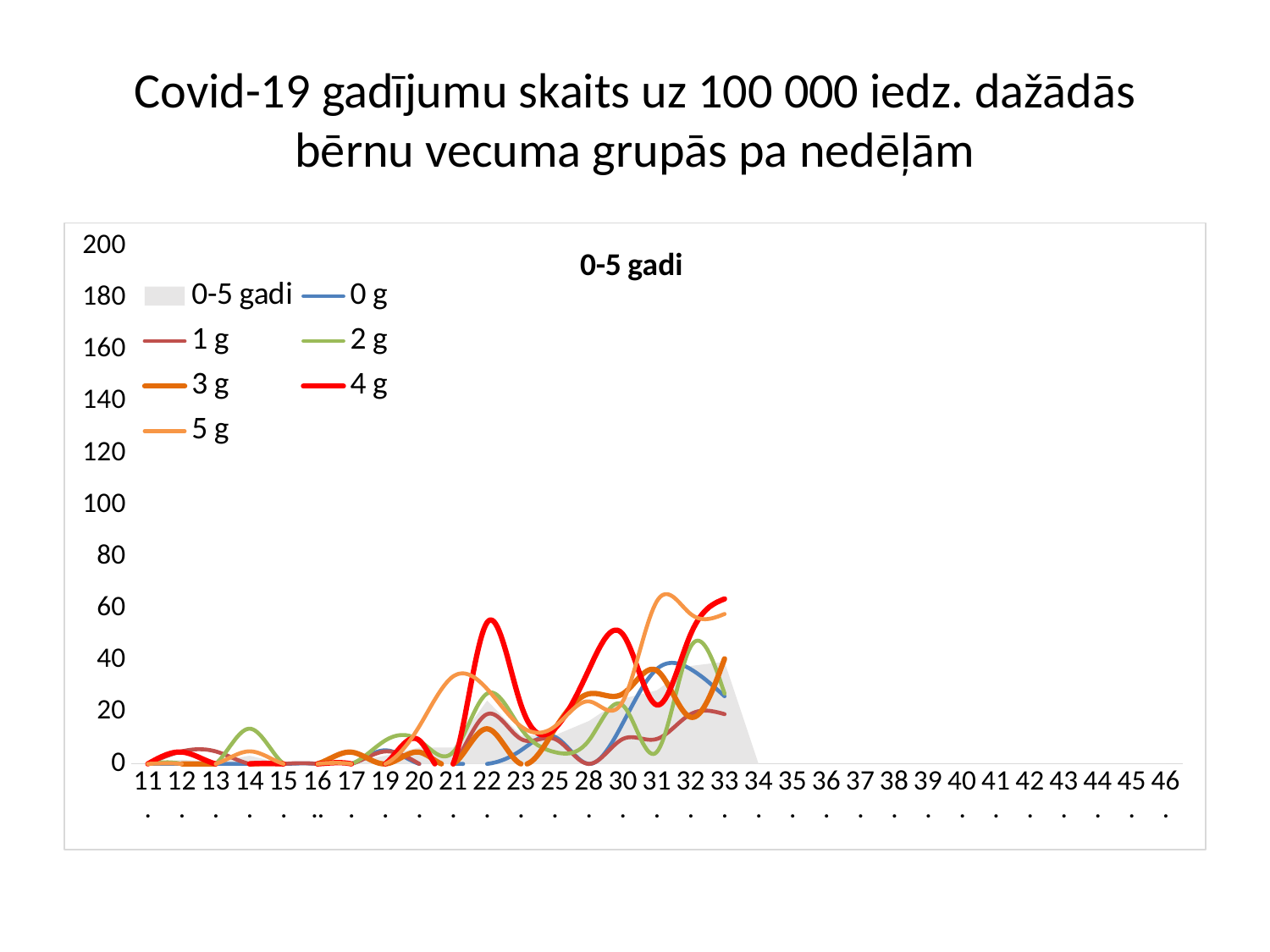
Is the value for the 4 g series at week 22 greater or less than 40? greater Is the value for the 2 g series at week 14 greater or less than 40? less Is the value for the 4 g series at week 30 greater or less than 40? greater How many series does the chart legend list? 7 Do the values of the 0-5 gadi area series generally rise or fall from week 11 to week 33? rise At week 22, which series is larger: 4 g or 1 g? 4 g How many week labels are shown on the x axis? 31 What is the title shown inside the chart area? 0-5 gadi What kind of chart is shown on the slide? combination area and line chart What is the highest value shown on the y axis? 200